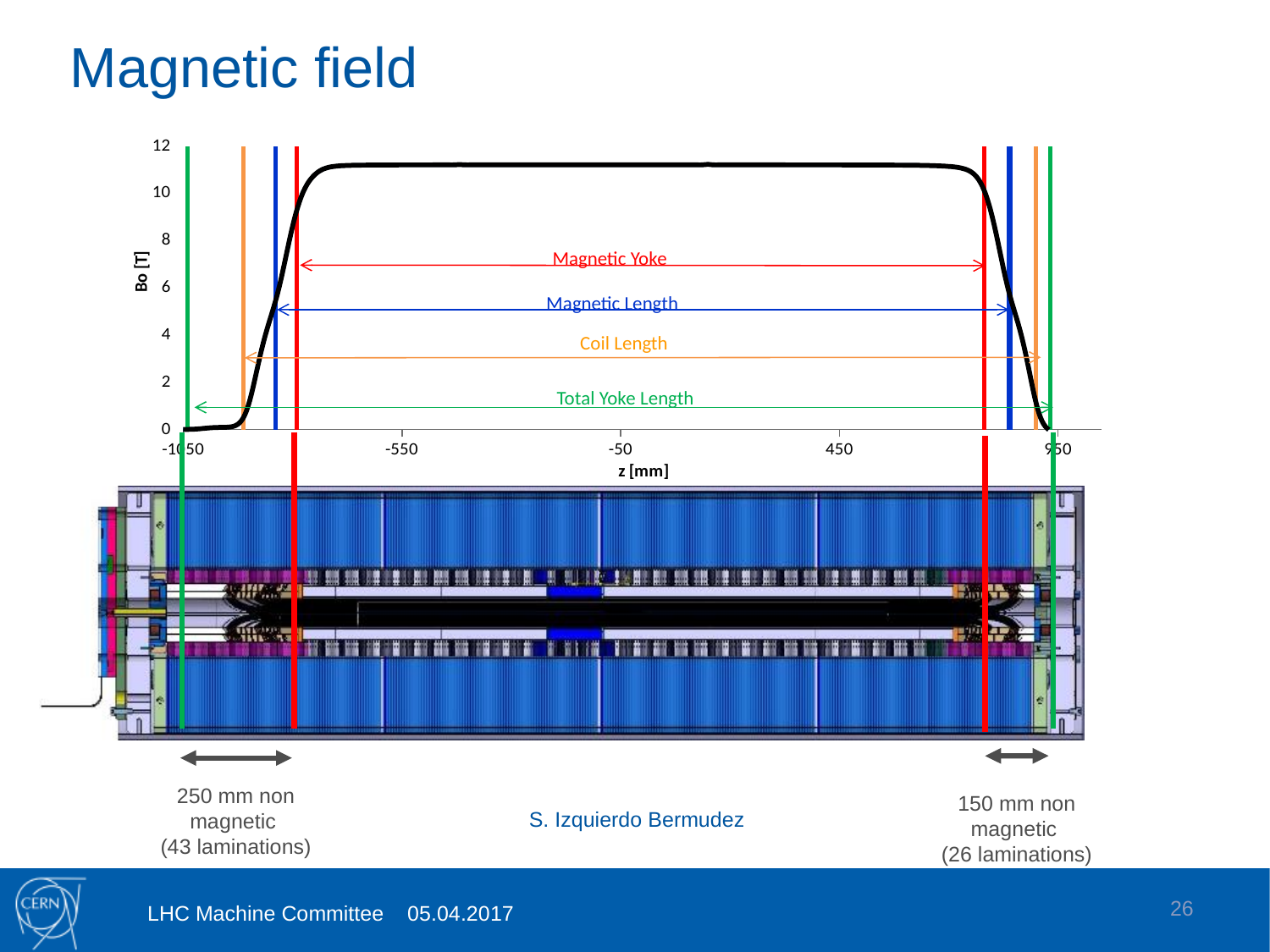
Which length annotation on the chart is drawn in red? Magnetic Yoke Is the value of Bo at z = -50 mm greater or less than 10? greater Does the plotted field rise or fall as z goes from 450 mm to 950 mm? fall What is the label of the x axis of the chart? z [mm] What is the label of the y axis of the chart? Bo [T] Is the value of Bo at z = 450 mm greater or less than 12? less How many length annotations (labelled double arrows) are drawn on the chart? 4 Does the plotted field rise or fall as z goes from -1050 mm to -550 mm? rise Is the value of Bo at z = 950 mm greater or less than 2? less What kind of chart is shown on the slide? line chart